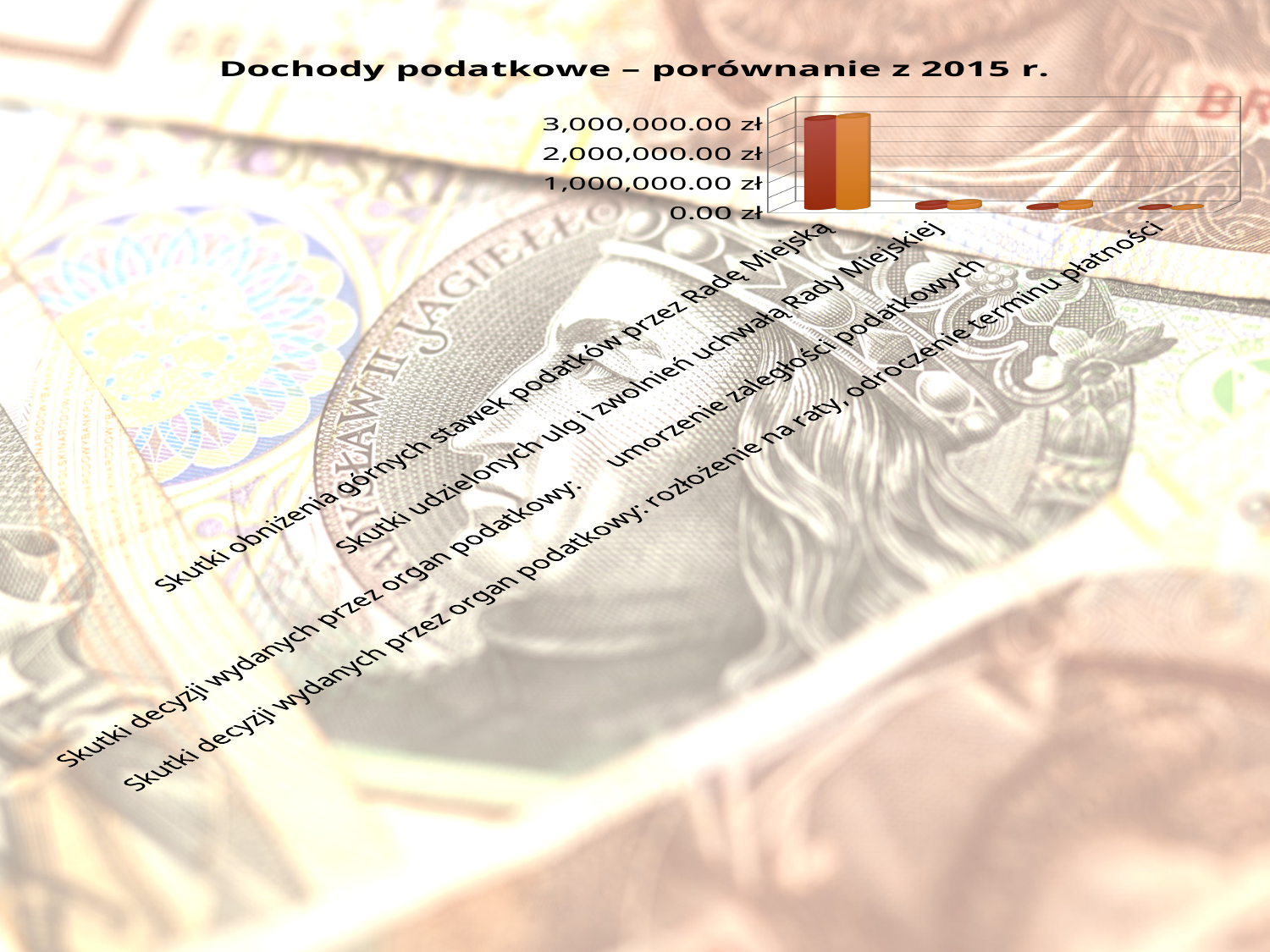
Which category has larger values: 'Skutki obniżenia górnych stawek podatków przez Radę Miejską' or 'Skutki decyzji wydanych przez organ podatkowy: umorzenie zaległości podatkowych'? Skutki obniżenia górnych stawek podatków przez Radę Miejską How many categories are shown on the x axis of the chart? 4 Are the values for 'Skutki obniżenia górnych stawek podatków przez Radę Miejską' greater or less than 2,000,000.00 zł? greater Are the values for 'Skutki decyzji wydanych przez organ podatkowy: umorzenie zaległości podatkowych' greater or less than 1,000,000.00 zł? less What is the title of the chart? Dochody podatkowe – porównanie z 2015 r. Are the values for 'Skutki udzielonych ulg i zwolnień uchwałą Rady Miejskiej' greater or less than 1,000,000.00 zł? less Which category has the highest bars in the chart? Skutki obniżenia górnych stawek podatków przez Radę Miejską What kind of chart is shown on the slide? bar chart What is the highest value labelled on the vertical axis of the chart? 3,000,000.00 zł How many bars are shown for each category in the chart? 2